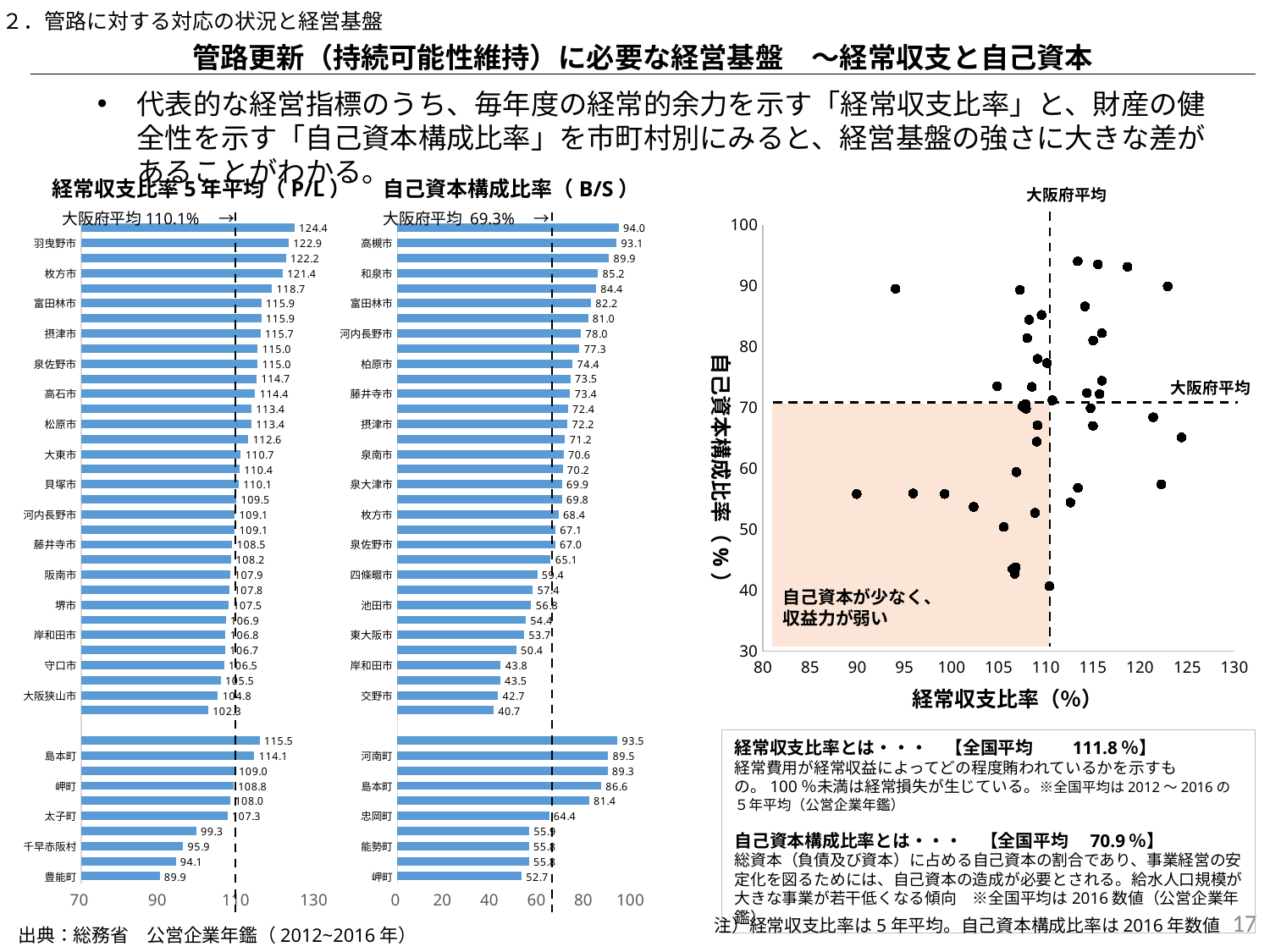
What kind of chart is the chart on the right of the slide with 経常収支比率（%） on the x axis and 自己資本構成比率（%） on the y axis? scatter plot In the 経常収支比率５年平均（P/L） bar chart, what is the value for 豊能町? 89.9 In the 自己資本構成比率（B/S） bar chart, what is the difference between 和泉市 and 岸和田市? 41.4 In the 経常収支比率５年平均（P/L） bar chart, which is larger, 枚方市 or 堺市? 枚方市 In the 経常収支比率５年平均（P/L） bar chart, what is the value for 羽曳野市? 122.9 In the 自己資本構成比率（B/S） bar chart, which is larger, 河南町 or 忠岡町? 河南町 In the 経常収支比率５年平均（P/L） bar chart, what is the 大阪府平均 value shown? 110.1% In the 自己資本構成比率（B/S） bar chart, what is the value for 交野市? 42.7 What kind of chart is the 経常収支比率５年平均（P/L） chart? bar chart In the 自己資本構成比率（B/S） bar chart, what is the value for 高槻市? 93.1 In the 経常収支比率５年平均（P/L） bar chart, is the value for 千早赤阪村 greater or less than 110? less In the 自己資本構成比率（B/S） bar chart, what is the 大阪府平均 value shown? 69.3%